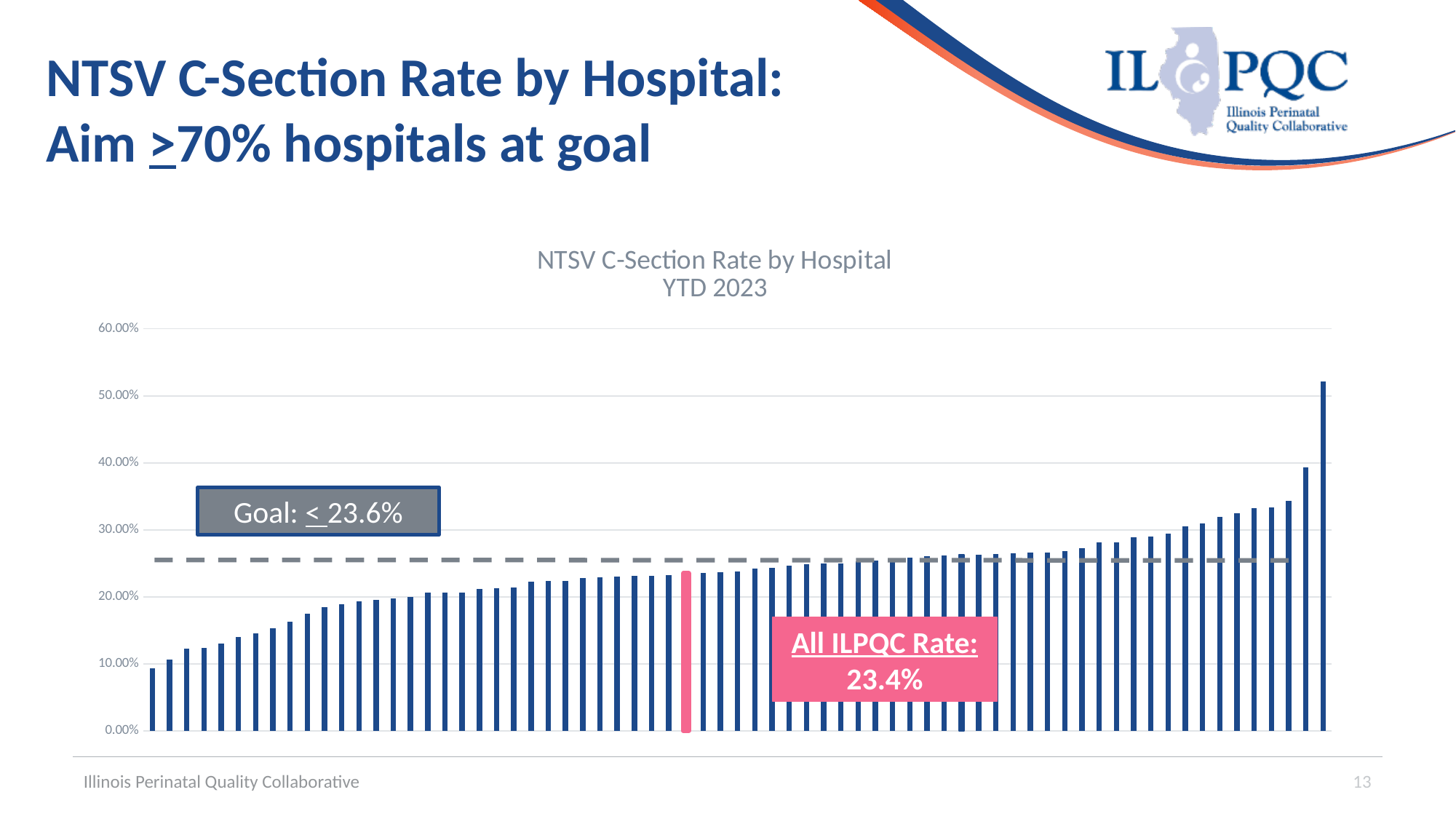
Do the bar values rise or fall from left to right along the x axis? Rise Which is larger, the goal value or the All ILPQC Rate? The goal value What does the horizontal dashed line on the chart represent? The goal of ≤ 23.6% Is the value of the tallest bar greater or less than 50.00%? greater What is the difference between the goal value of 23.6% and the All ILPQC Rate of 23.4%? 0.2% Which is larger, the pink highlighted bar or the rightmost bar? The rightmost bar What is the title of the chart? NTSV C-Section Rate by Hospital YTD 2023 Is the value of the second-tallest bar greater or less than 40.00%? less Is the value of the shortest bar (leftmost) greater or less than 10.00%? less What kind of chart is shown on the slide? Bar chart What goal value is shown on the chart? ≤ 23.6% What is the All ILPQC Rate shown on the chart? 23.4%